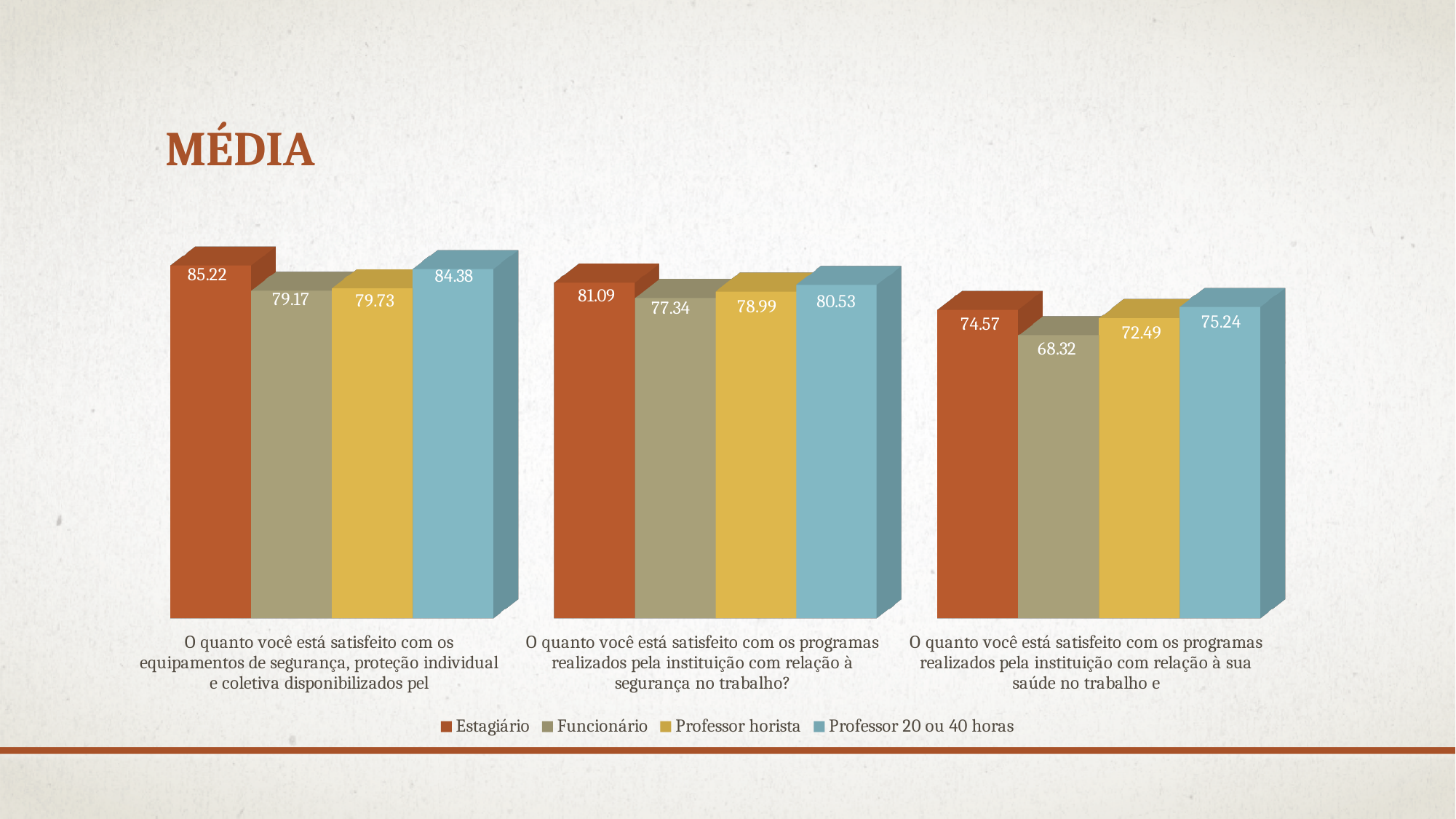
What is the difference between the Estagiário and Funcionário values in the category about programs related to safety at work (segurança no trabalho)? 3.75 Which series has the highest value in the category about satisfaction with safety equipment (equipamentos de segurança)? Estagiário What is the value for Professor 20 ou 40 horas in the category about programs related to health at work (saúde no trabalho)? 75.24 What is the title of the slide? MÉDIA What is the value for Professor horista in the category about programs related to safety at work (segurança no trabalho)? 78.99 What is the value for Funcionário in the category about programs related to health at work (saúde no trabalho)? 68.32 How many categories are shown on the x axis of the chart? 3 In the category about programs related to health at work (saúde no trabalho), which is larger: the value for Estagiário or for Professor horista? Estagiário How many series does the legend list? 4 Which series has the lowest value in the category about programs related to health at work (saúde no trabalho)? Funcionário What is the value for Estagiário in the category about satisfaction with safety equipment (equipamentos de segurança)? 85.22 What kind of chart is shown on the slide? Bar chart